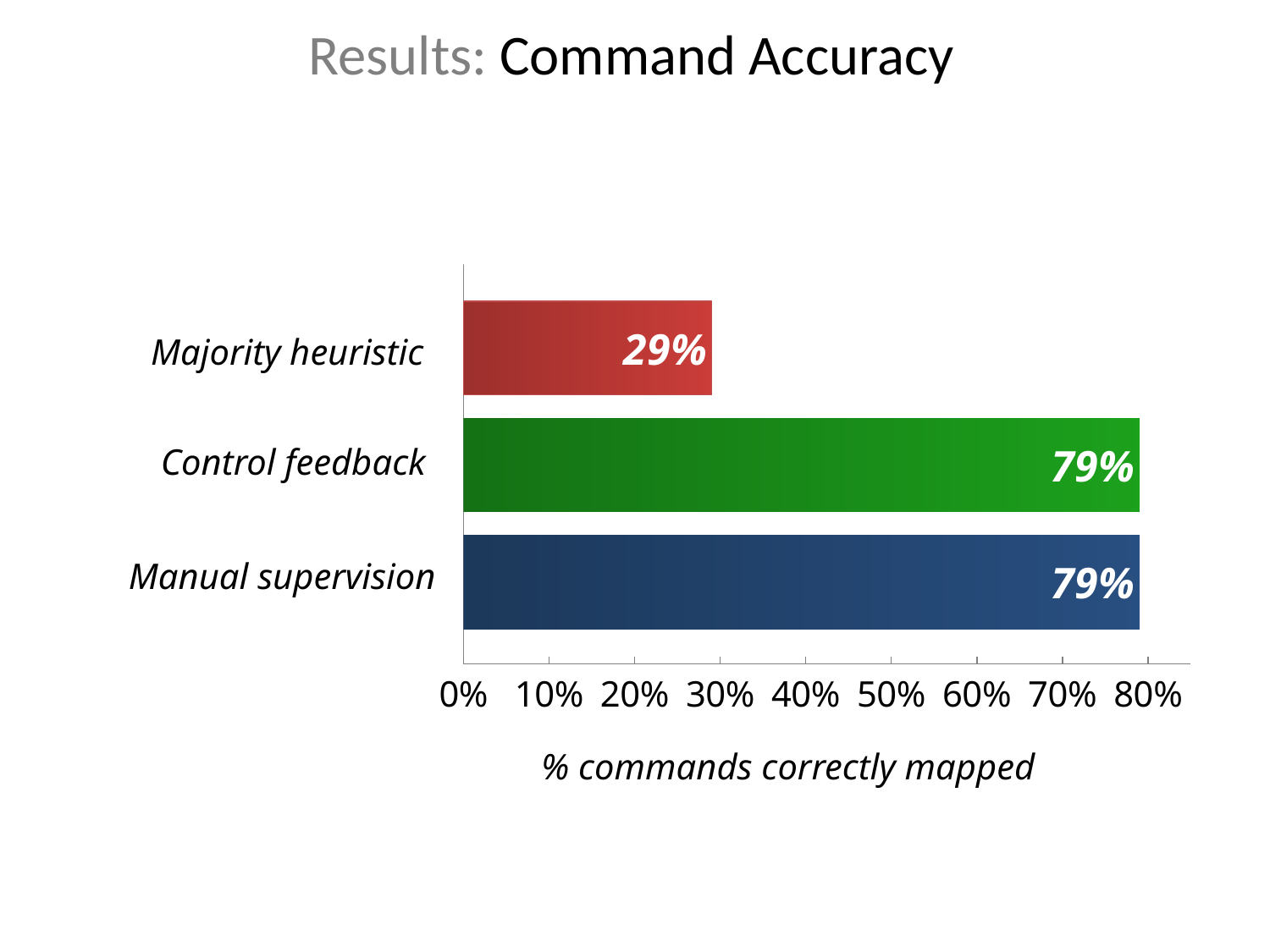
Is the value for Control feedback greater or less than 70%? greater What kind of chart is shown on the slide? bar chart What is the value for Manual supervision? 79% What is the value for Majority heuristic? 29% What colour is the bar for Majority heuristic? red Is the value for Majority heuristic greater or less than 50%? less What is the x-axis label of the chart? % commands correctly mapped Which is larger, the value for Manual supervision or the value for Majority heuristic? Manual supervision Which category has the lowest value? Majority heuristic What is the value for Control feedback? 79% What is the difference between the values for Control feedback and Majority heuristic? 50% How many categories are shown in the chart? 3